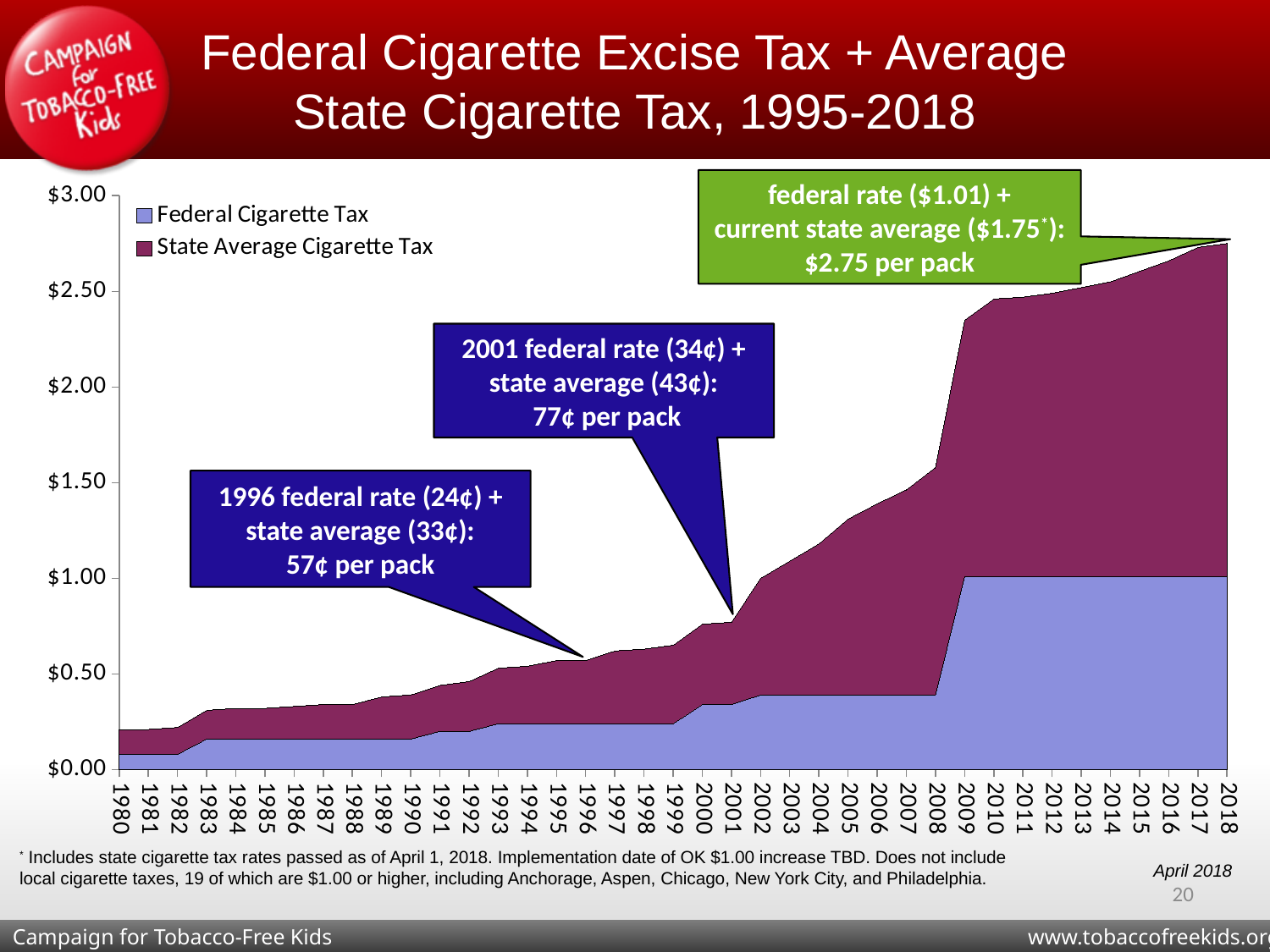
Is the combined federal plus state average tax in 2009 greater or less than $2.00? greater What is the combined federal rate plus current state average per pack shown in the green callout? $2.75 per pack According to the callout, what was the federal cigarette tax rate in 1996? 24¢ What are the two series named in the legend? Federal Cigarette Tax; State Average Cigarette Tax How many series does the legend list? 2 What is the combined federal rate plus state average per pack in 2001, as shown in the callout? 77¢ per pack Which is larger in 2018: the federal rate or the current state average? current state average What is the difference between the combined per-pack tax in 2001 (77¢) and in 1996 (57¢)? 20¢ What is the current federal cigarette tax rate shown in the green callout? $1.01 Does the combined federal plus state average cigarette tax generally rise or fall from 1980 to 2018? rise What kind of chart is shown on the slide? stacked area chart According to the callout, what was the state average cigarette tax in 2001? 43¢